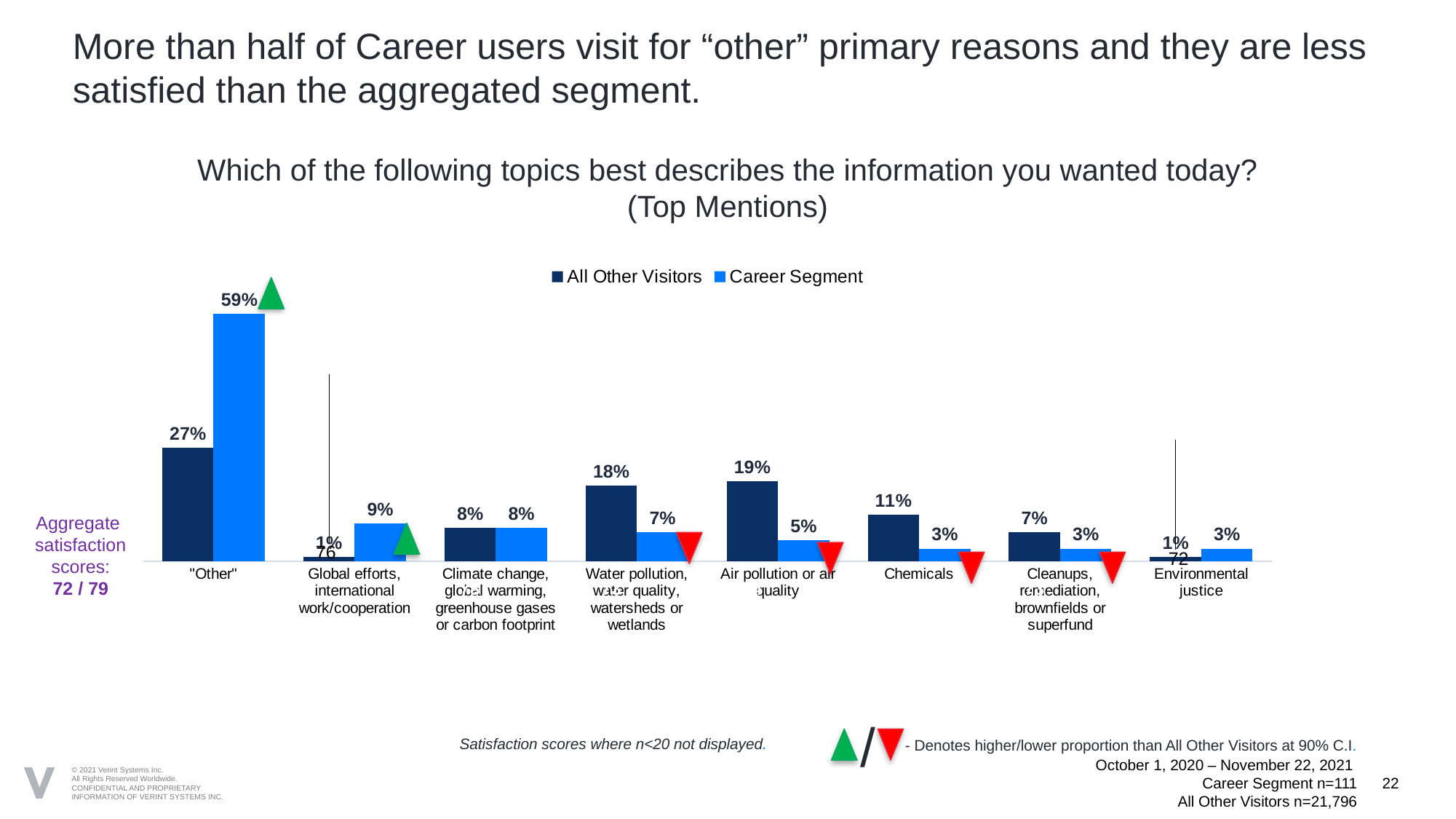
What type of chart is shown on the slide? Bar chart What is the difference between the Career Segment and All Other Visitors values for "Other"? 32 percentage points How many topic categories are shown on the x axis? 8 Which topic has the lowest value for the Career Segment? Chemicals, Cleanups/remediation/brownfields/superfund, and Environmental justice (all 3%) What is the Career Segment value for Chemicals? 3% What are the aggregate satisfaction scores shown on the left of the chart? 72 / 79 What percentage of the Career Segment selected "Other"? 59% Which topic has the highest value for All Other Visitors? "Other" What percentage of All Other Visitors selected Air pollution or air quality? 19% How many series does the legend list? 2 For Water pollution, water quality, watersheds or wetlands, which series has the larger value: All Other Visitors or Career Segment? All Other Visitors For Climate change, global warming, greenhouse gases or carbon footprint, what are the values for All Other Visitors and Career Segment? 8% and 8%